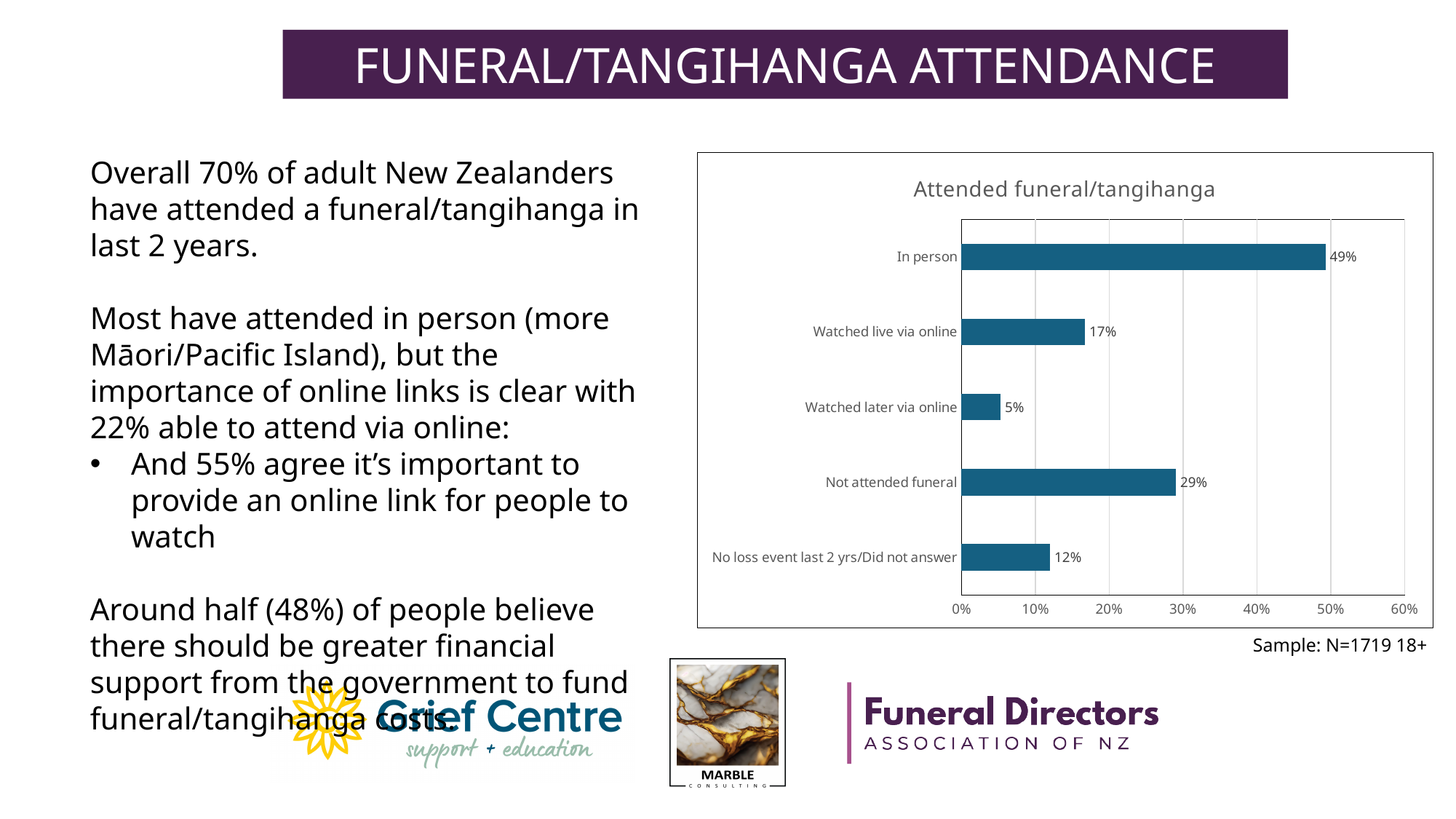
What kind of chart is shown on the slide? Bar chart What is the value for "In person" in the Attended funeral/tangihanga chart? 49% How many categories are shown in the chart? 5 What is the difference between the values for "In person" and "Not attended funeral"? 20% What is the value for "Watched later via online"? 5% Which category has the lowest value in the chart? Watched later via online Which is larger, the value for "Watched live via online" or "No loss event last 2 yrs/Did not answer"? Watched live via online What is the title of the chart? Attended funeral/tangihanga Which category has the highest value in the chart? In person What is the value for "Not attended funeral"? 29% What is the value for "No loss event last 2 yrs/Did not answer"? 12% What is the value for "Watched live via online"? 17%